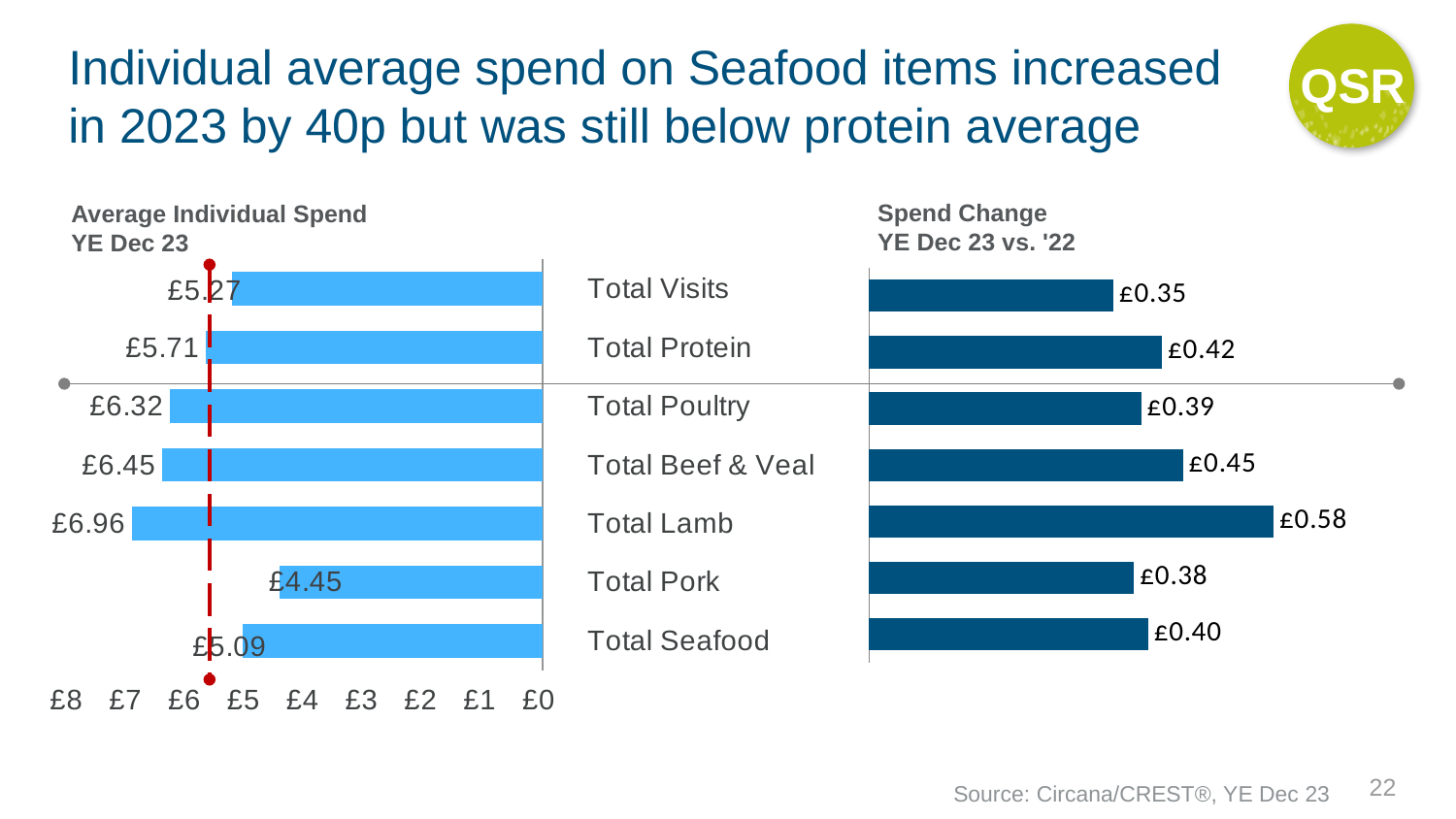
On the Spend Change YE Dec 23 vs. '22 chart, what is the difference between Total Lamb and Total Visits? £0.23 On the Spend Change YE Dec 23 vs. '22 chart, which category has the smallest change? Total Visits On the Average Individual Spend YE Dec 23 chart, is the value for Total Lamb greater or less than £6? greater On the Average Individual Spend YE Dec 23 chart, what is the difference between Total Protein and Total Seafood? £0.62 On the Average Individual Spend YE Dec 23 chart, which category has the highest value? Total Lamb How many categories are shown on the Spend Change YE Dec 23 vs. '22 chart? 7 What is the title of the chart on the right side of the slide? Spend Change YE Dec 23 vs. '22 On the Spend Change YE Dec 23 vs. '22 chart, what is the value for Total Lamb? £0.58 On the Average Individual Spend YE Dec 23 chart, which category has the lowest value? Total Pork On the Average Individual Spend YE Dec 23 chart, what is the value for Total Seafood? £5.09 On the Average Individual Spend YE Dec 23 chart, which is larger: Total Seafood or Total Pork? Total Seafood What kind of chart is the Average Individual Spend YE Dec 23 chart? bar chart